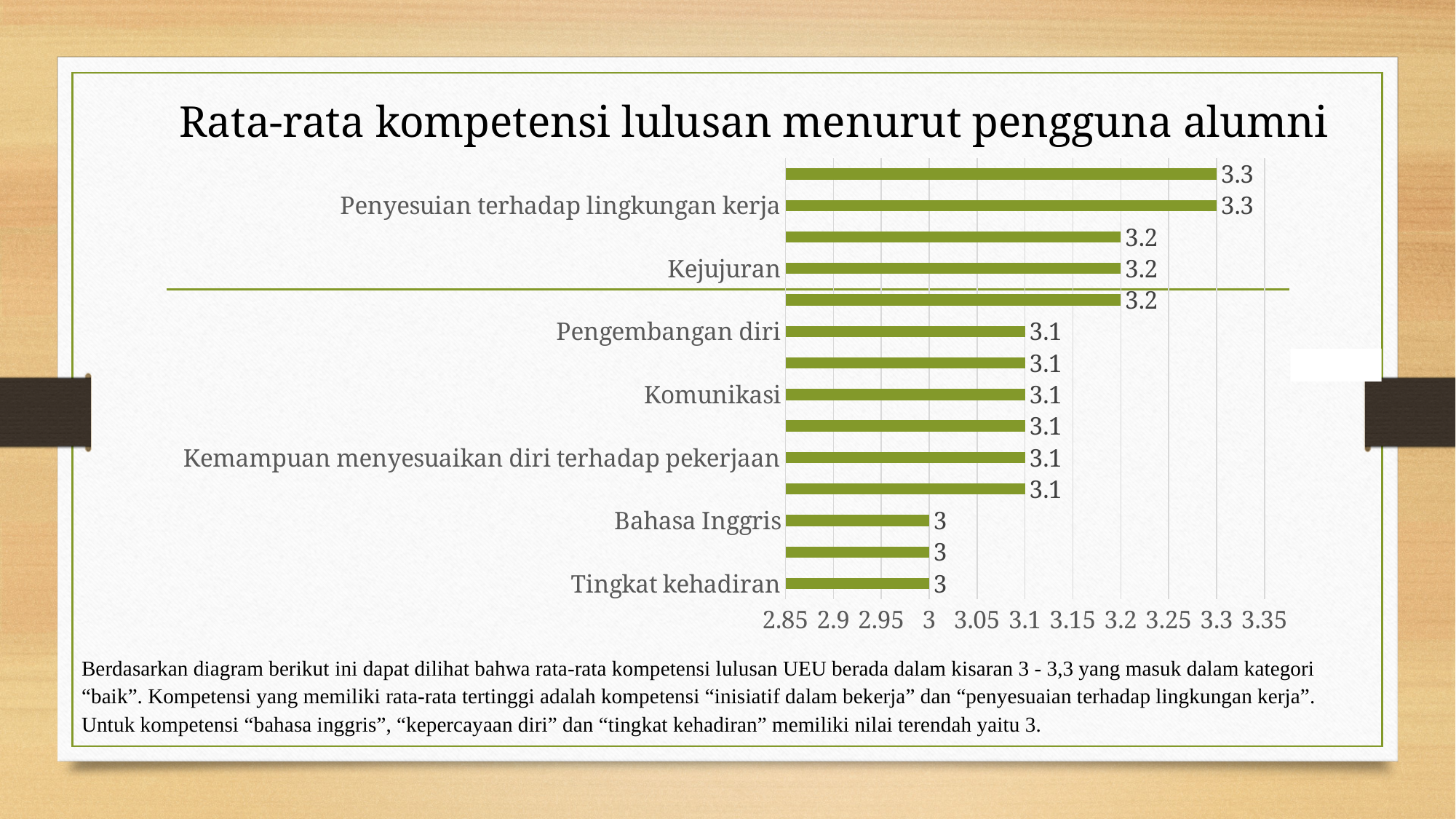
What is the value for Kejujuran? 3.2 What is the value for Bahasa Inggris? 3 What is the value for Pengembangan diri? 3.1 What is the title of the chart? Rata-rata kompetensi lulusan menurut pengguna alumni Which has a larger value, Kejujuran or Komunikasi? Kejujuran What kind of chart is shown on the slide? bar chart What is the value for Tingkat kehadiran? 3 What is the value for Penyesuian terhadap lingkungan kerja? 3.3 What is the highest value shown in the chart? 3.3 What is the difference between the values for Penyesuian terhadap lingkungan kerja and Tingkat kehadiran? 0.3 How many bars are plotted in the chart? 14 What is the lowest value shown in the chart? 3